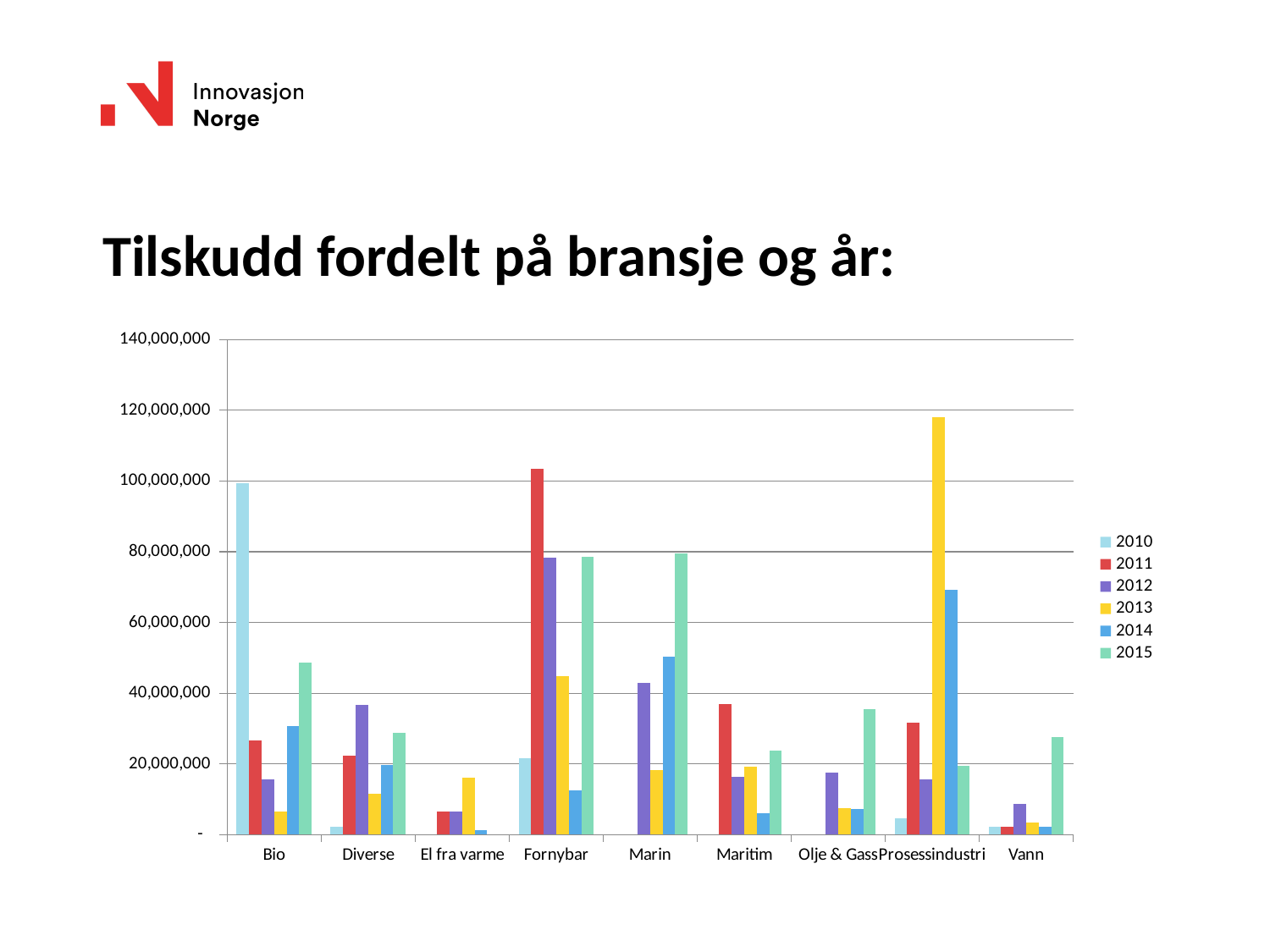
Which year has the highest bar for Diverse? 2012 Is the value for Bio in 2010 greater or less than 80,000,000? greater What kind of chart is shown on the slide? bar chart How many industry categories are shown on the x axis? 9 Which category has the highest bar for 2010? Bio Which year has the highest bar for Prosessindustri? 2013 Is the value for Prosessindustri in 2013 greater or less than 100,000,000? greater How many series does the legend list? 6 What is the title of the chart? Tilskudd fordelt på bransje og år: Is the value for El fra varme in 2013 greater or less than 20,000,000? less Which is larger for Fornybar: the 2011 value or the 2013 value? 2011